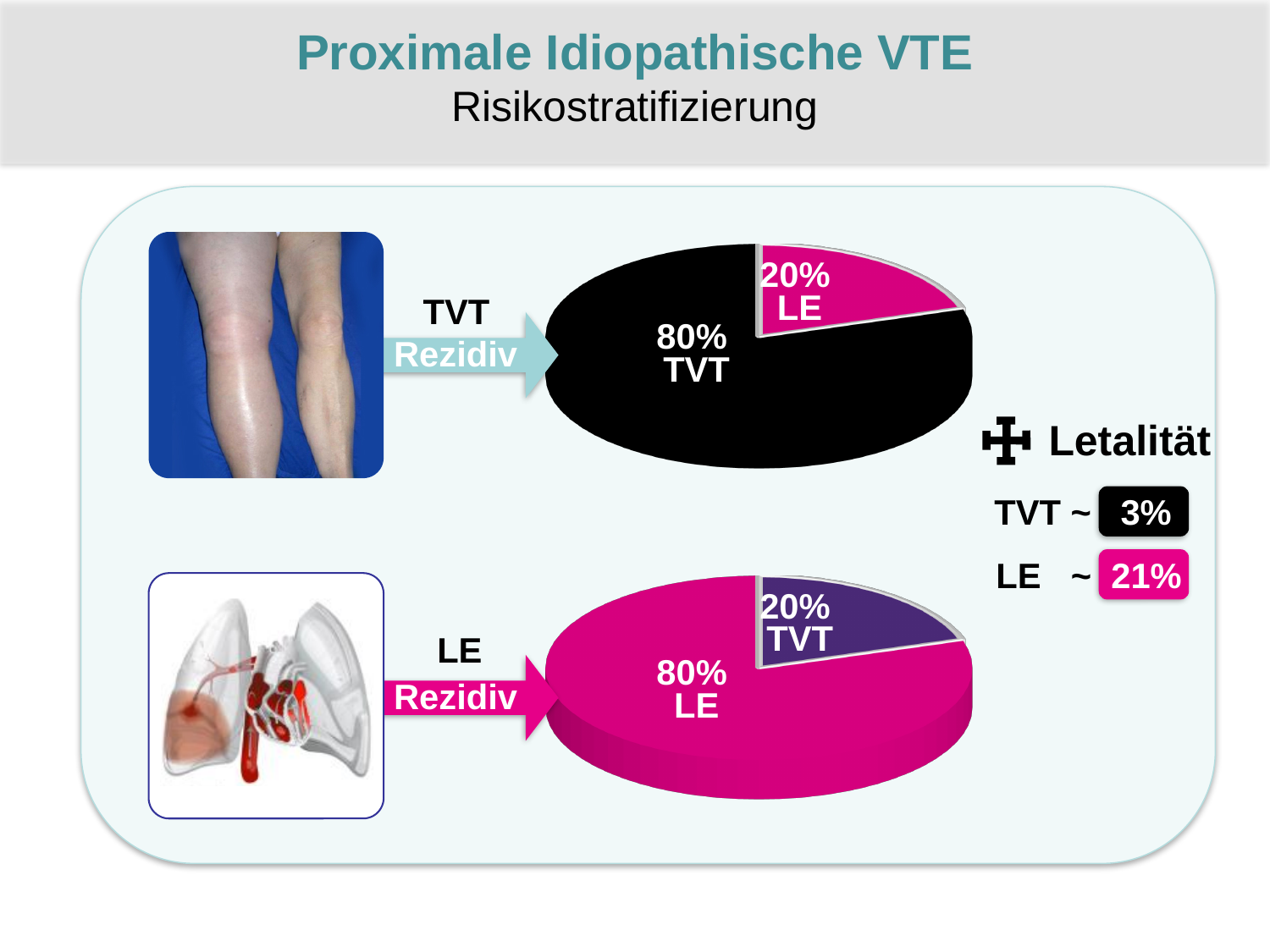
In the bottom pie chart (LE Rezidiv), what colour is the 80% LE slice? magenta/pink In the top pie chart (TVT Rezidiv), what share is labelled TVT? 80% What kind of chart is used for the TVT Rezidiv data on the slide? pie chart In the bottom pie chart (LE Rezidiv), what share is labelled LE? 80% In the bottom pie chart (LE Rezidiv), what share is labelled TVT? 20% How many slices does the top pie chart (TVT Rezidiv) have? 2 In the top pie chart (TVT Rezidiv), which slice is the largest? TVT In the bottom pie chart (LE Rezidiv), which slice is larger, LE or TVT? LE How many pie charts are shown on the slide? 2 In the top pie chart (TVT Rezidiv), what is the difference between the TVT share and the LE share? 60% In the top pie chart (TVT Rezidiv), what share is labelled LE? 20% In the bottom pie chart (LE Rezidiv), which slice is the smallest? TVT